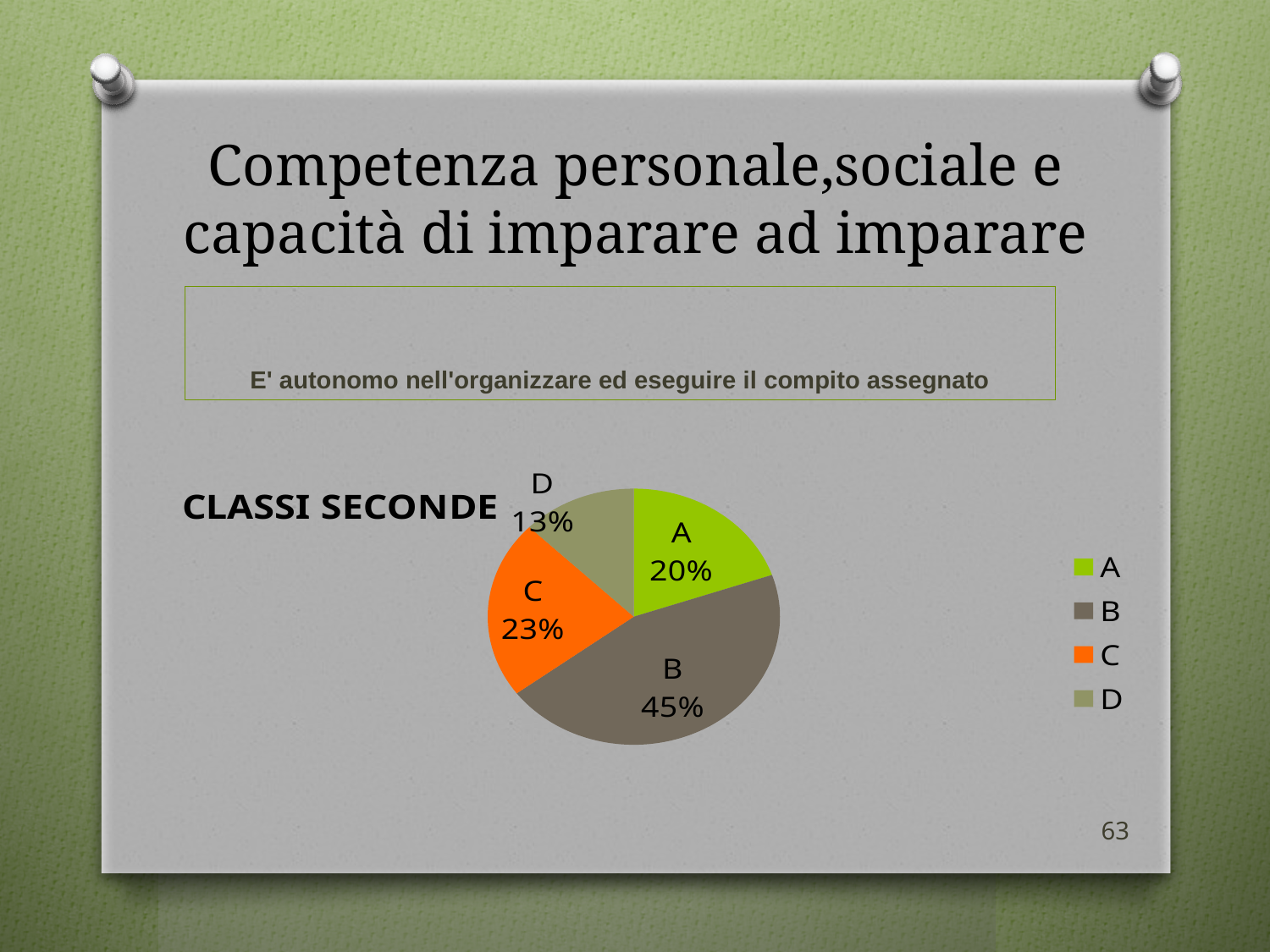
What is the difference in percentage points between category B and category A? 25 What colour is the slice for category C? orange How many categories does the pie chart have? 4 What share of the pie does category C have? 23% How many entries does the legend list? 4 What share of the pie does category D have? 13% Which category has the smallest slice of the pie? D What share of the pie does category A have? 20% Which is larger, the slice for C or the slice for A? C Which category has the largest slice of the pie? B What kind of chart is shown on the slide? pie chart